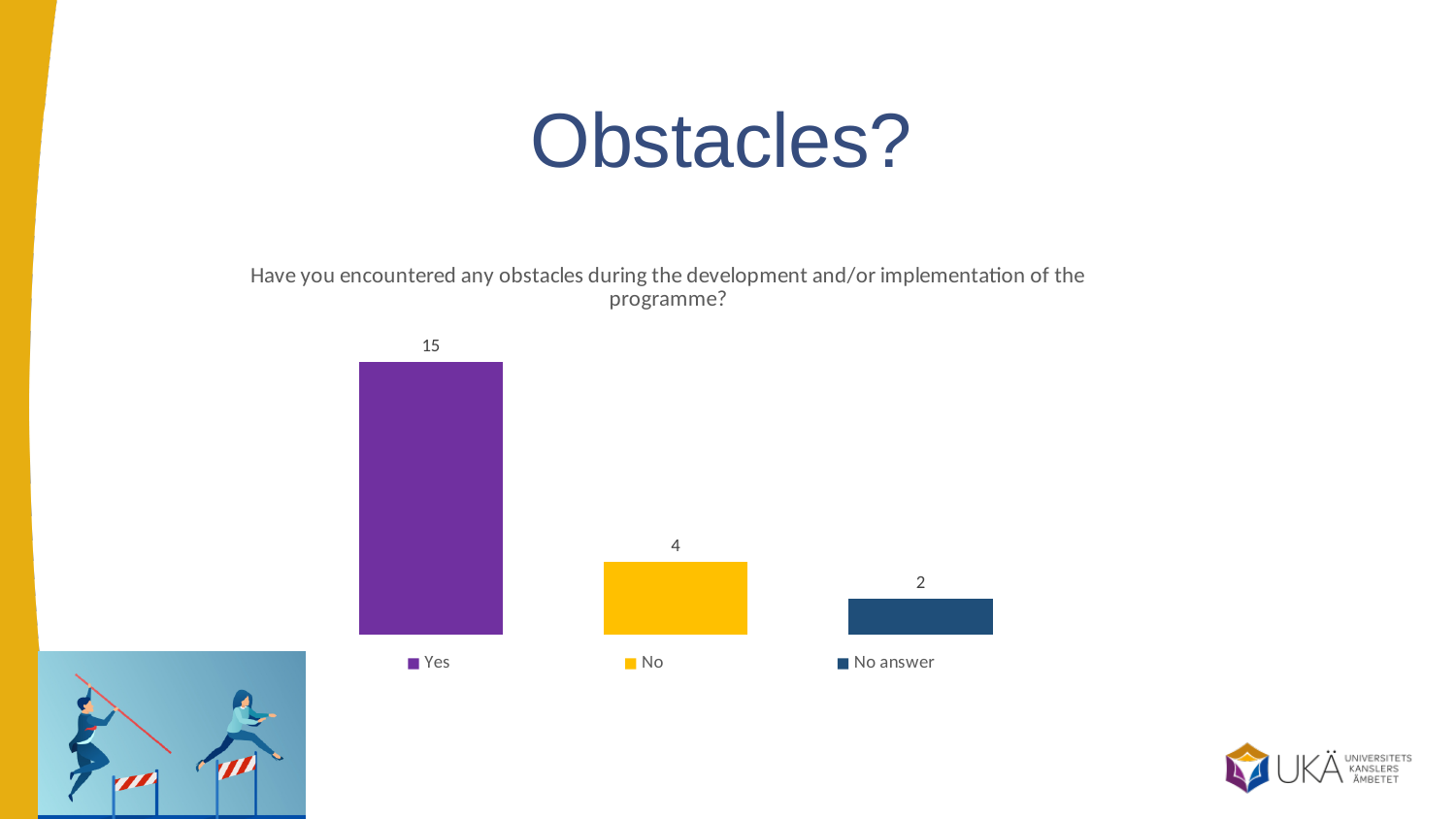
What is the difference between the values for "Yes" and "No"? 11 What kind of chart is shown on the slide? Bar chart Which category has the highest value? Yes What is the value for "No"? 4 What is the title of the chart? Have you encountered any obstacles during the development and/or implementation of the programme? What is the total of all three values in the chart? 21 Which is larger, the value for "No" or the value for "No answer"? No What is the difference between the values for "No" and "No answer"? 2 What is the value for "Yes"? 15 What is the value for "No answer"? 2 Which category has the lowest value? No answer How many categories are shown in the chart? 3